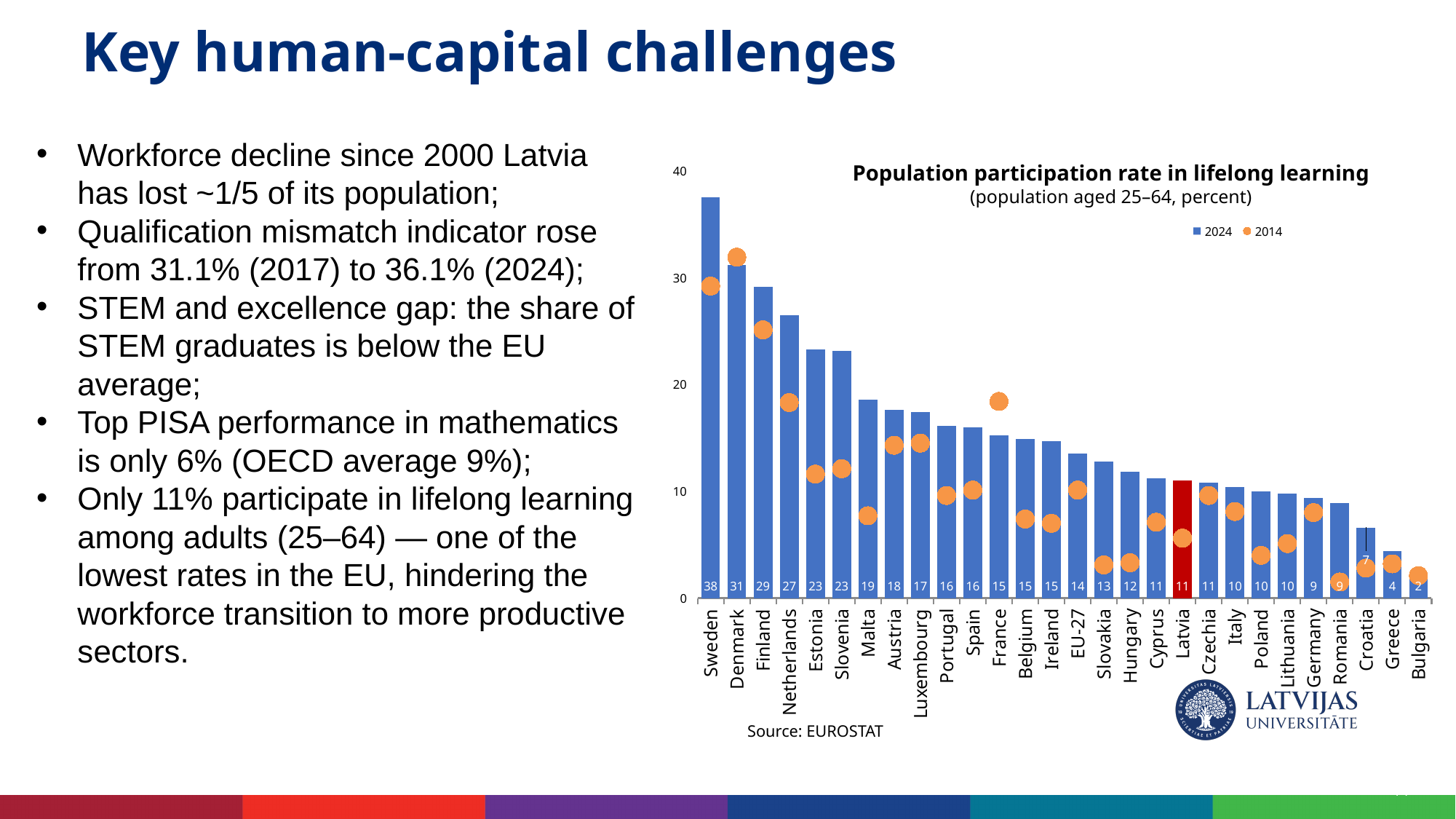
How many categories are shown on the x axis of the chart? 28 What is the difference between the 2024 values for Sweden and Bulgaria? 36 How many series does the chart legend list? 2 Do the 2024 values rise or fall from left to right along the x axis? fall What kind of chart is used to show the 2024 values? bar chart What is the 2024 value shown for Latvia in the lifelong learning chart? 11 What is the 2024 population participation rate in lifelong learning for Sweden? 38 Is the 2014 value for France greater or less than 10? greater What is the 2024 value shown for EU-27? 14 Which country has the highest 2024 participation rate in lifelong learning? Sweden Which has the larger 2024 value, Finland or Netherlands? Finland Which country has the lowest 2024 participation rate in lifelong learning? Bulgaria